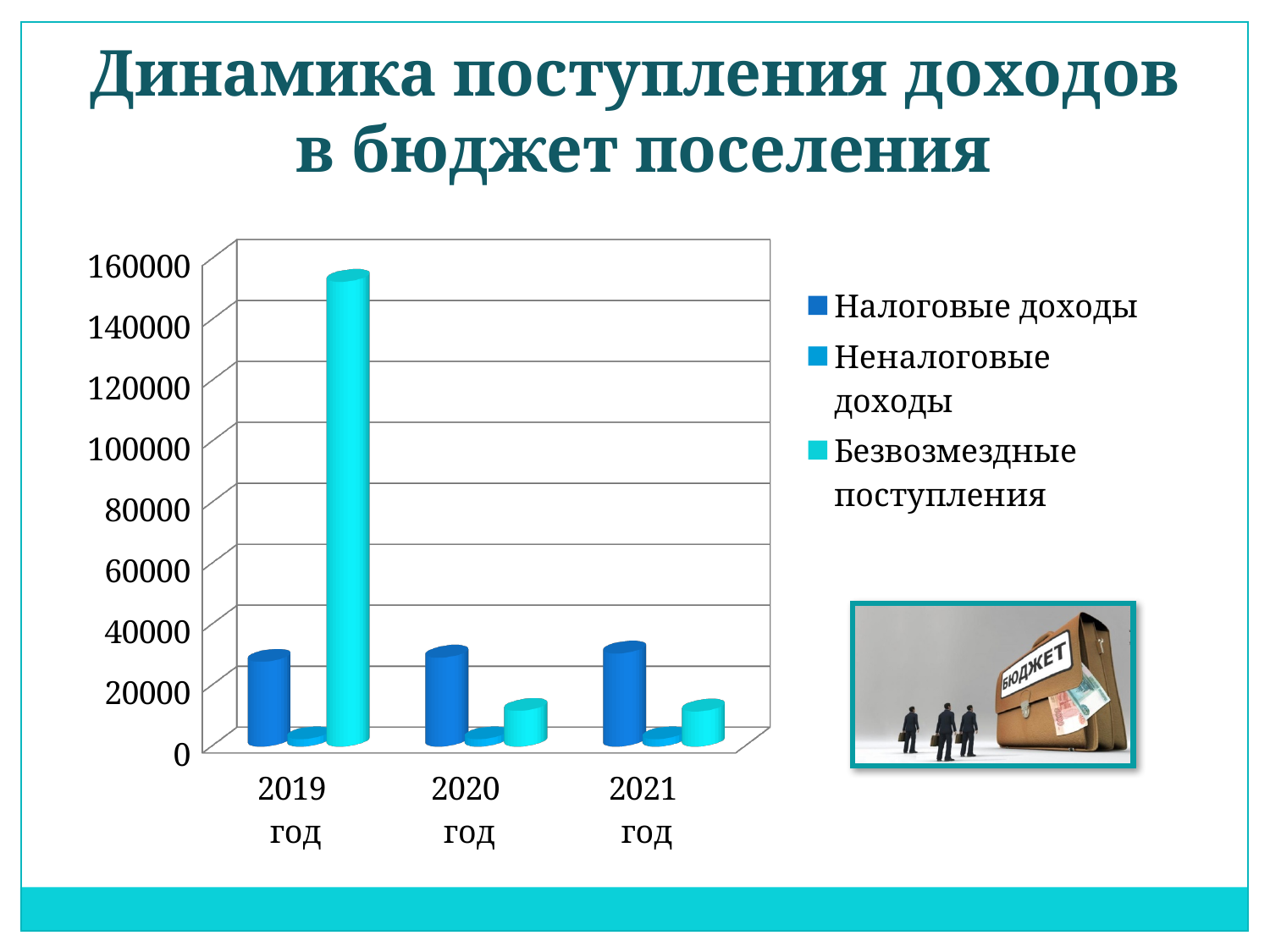
What kind of chart is shown on the slide? Bar chart Which is larger: Безвозмездные поступления in 2019 год or in 2021 год? 2019 год What is the title of the slide containing the chart? Динамика поступления доходов в бюджет поселения Is the value for Безвозмездные поступления in 2019 год greater or less than 140000? greater Which series has the lowest value in 2021 год? Неналоговые доходы Is the value for Безвозмездные поступления in 2020 год greater or less than 20000? less How many series does the legend list? 3 Which is larger in 2020 год: Налоговые доходы or Неналоговые доходы? Налоговые доходы Is the value for Налоговые доходы in 2021 год greater or less than 40000? less Does the value for Безвозмездные поступления rise or fall from 2019 год to 2020 год? fall How many years are shown on the x axis? 3 Which series has the highest value in 2019 год? Безвозмездные поступления